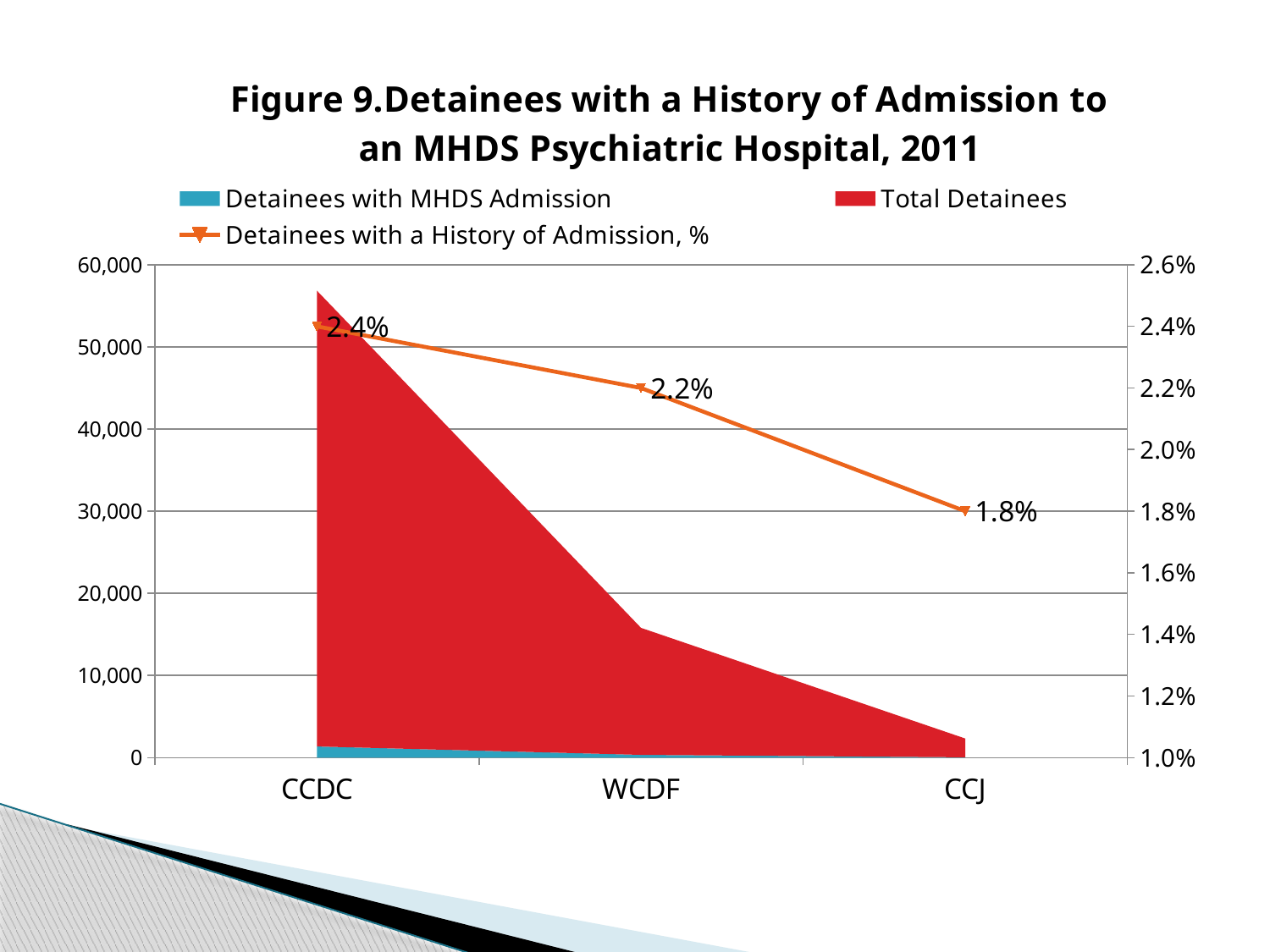
Is the Total Detainees value for CCDC greater or less than 50,000? greater Which facility has the lowest percentage of detainees with a history of admission? CCJ How many series does the legend list? 3 Does the percentage of detainees with a history of admission rise or fall from CCDC to CCJ? fall What is the value of Detainees with a History of Admission, % for CCJ? 1.8% Is the Total Detainees value for WCDF greater or less than 20,000? less What is the difference in percentage points between the history-of-admission percentage for CCDC and CCJ? 0.6% How many facilities are shown on the x axis? 3 What is the value of Detainees with a History of Admission, % for CCDC? 2.4% Which facility has the highest percentage of detainees with a history of admission? CCDC Which facility has a larger Total Detainees value, CCDC or WCDF? CCDC What is the value of Detainees with a History of Admission, % for WCDF? 2.2%